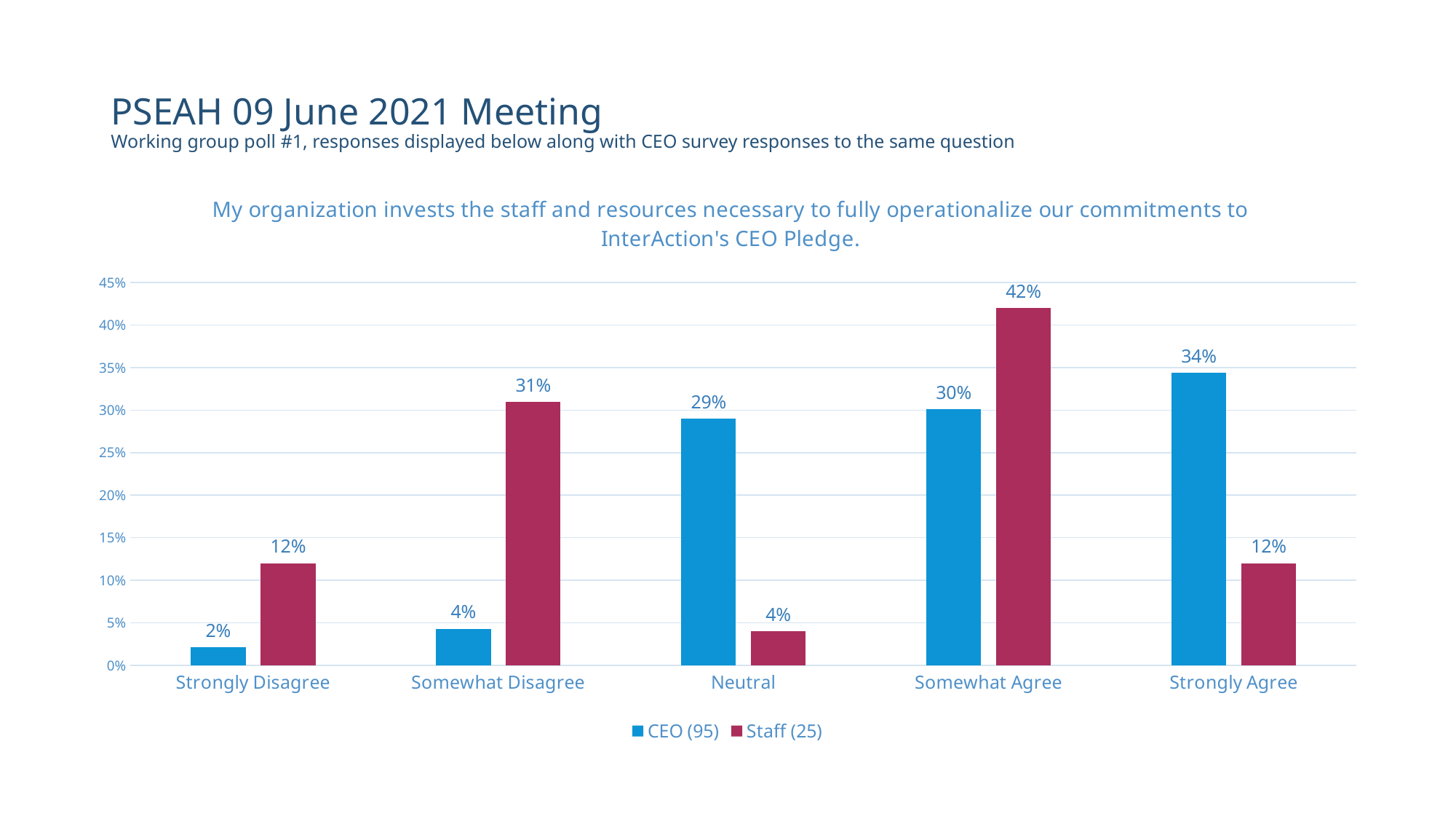
How many response categories are shown on the x axis? 5 Which category has the highest Staff (25) value? Somewhat Agree What is the difference between the Staff (25) and CEO (95) values for Somewhat Disagree? 27% For Neutral, which series has the larger value, CEO (95) or Staff (25)? CEO (95) What kind of chart is shown on the slide? Bar chart What is the CEO (95) value for Strongly Agree? 34% Which category has the lowest CEO (95) value? Strongly Disagree What is the Staff (25) value for Somewhat Agree? 42% How many series does the legend list? 2 What is the CEO (95) value for Neutral? 29% Which series is shown in blue? CEO (95) What is the Staff (25) value for Somewhat Disagree? 31%